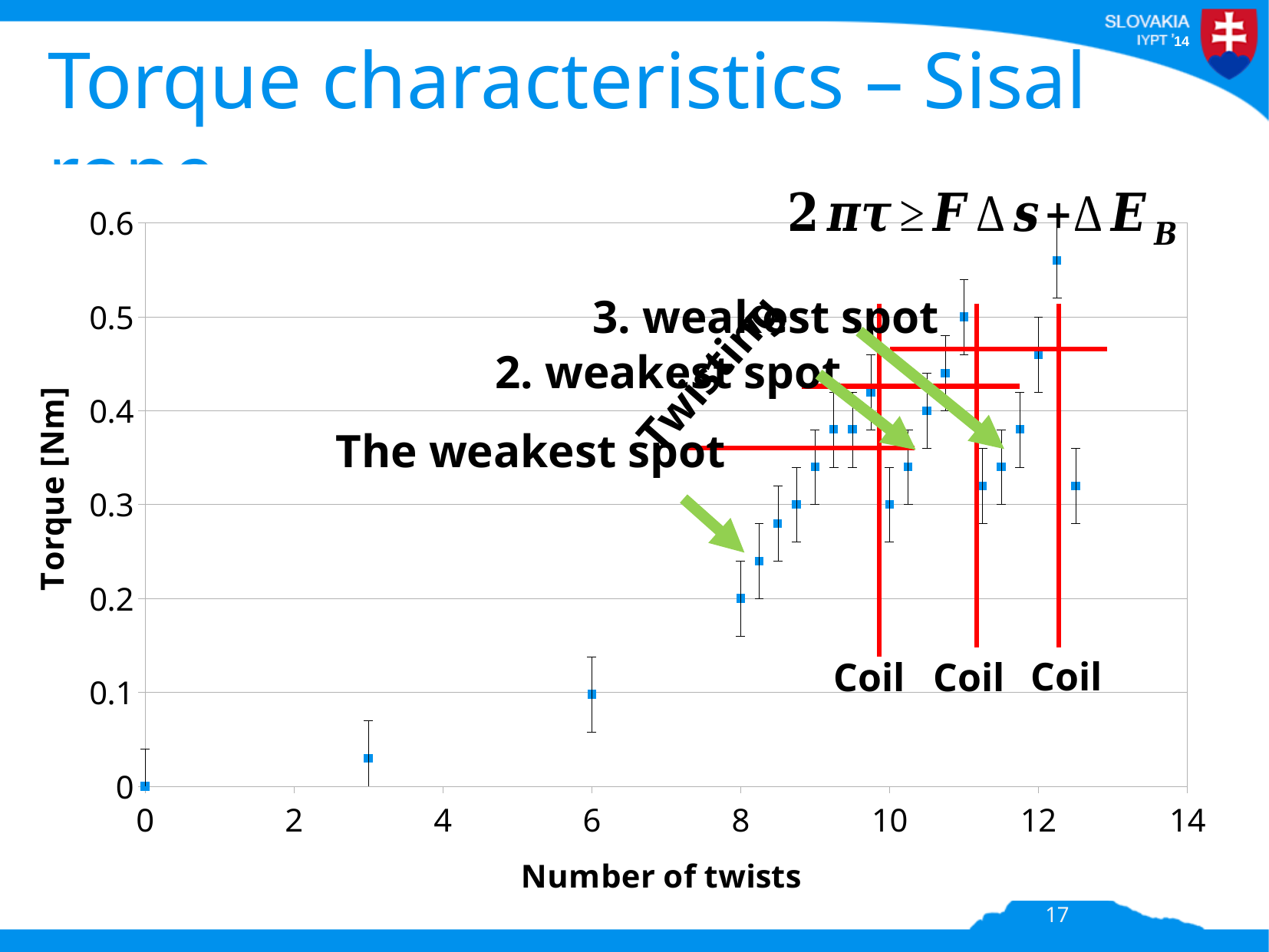
Which has the larger torque: the point at 3 twists or the point at 8 twists? 8 twists What kind of chart is shown on the slide? scatter chart Is the highest plotted torque value greater or less than 0.5 Nm? greater Is the torque at 3 twists greater or less than 0.1 Nm? less Is the torque at 12 twists greater or less than 0.4 Nm? greater How many vertical red lines labelled "Coil" are drawn on the chart? 3 What is the highest value shown on the horizontal axis? 14 What is the label of the horizontal axis? Number of twists Does the torque generally rise or fall as the number of twists increases? rise What is the label of the vertical axis? Torque [Nm] What is the torque value at 0 twists? 0